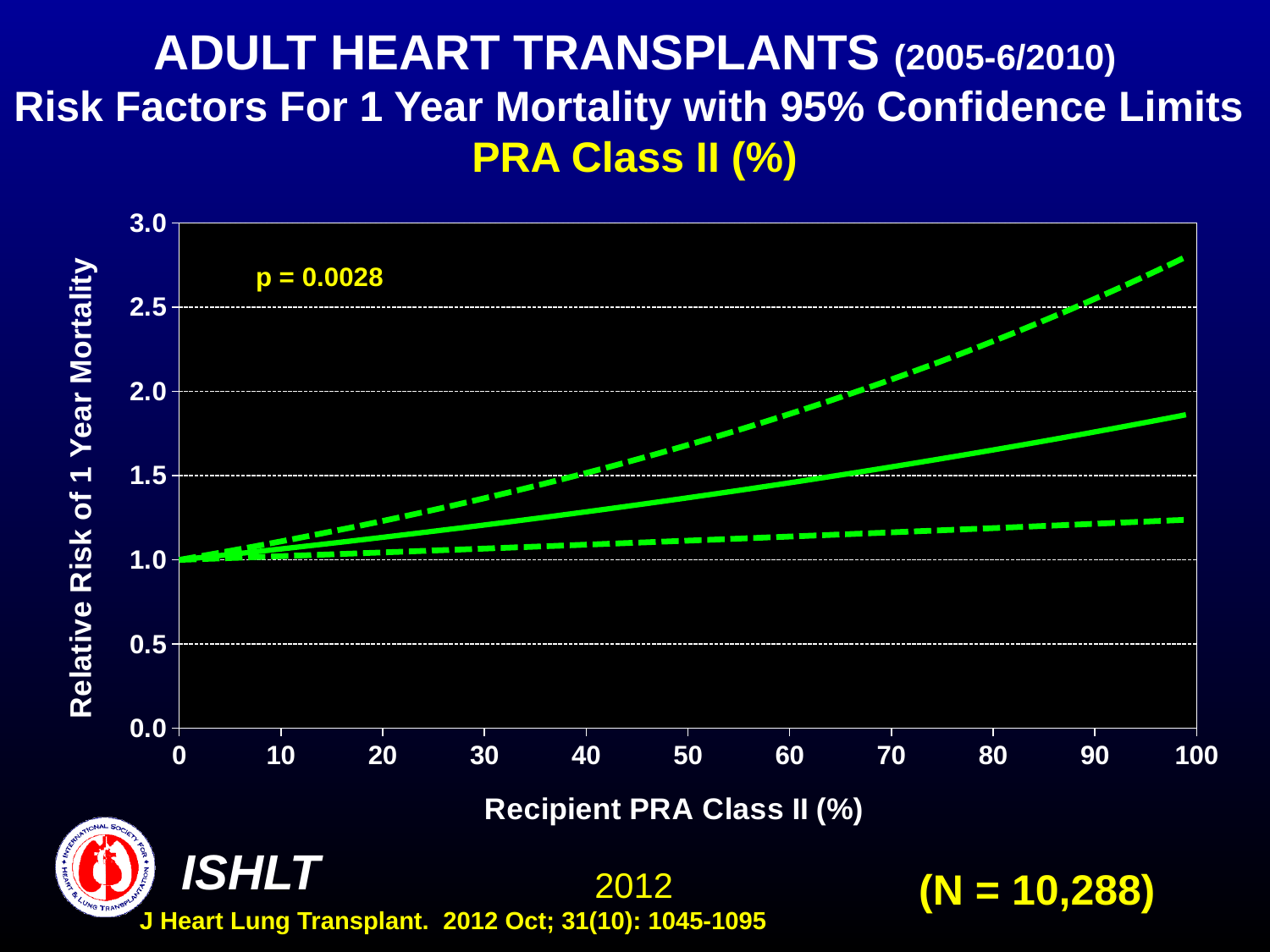
What p-value is shown on the chart? p = 0.0028 What sample size (N) is shown on the slide? N = 10,288 Does the relative risk of 1 year mortality (solid line) rise or fall as Recipient PRA Class II (%) increases? rise How many lines are plotted on the chart? 3 What kind of chart is shown on the slide? line chart Is the relative risk on the solid line at a Recipient PRA Class II of 100% greater or less than 1.5? greater Is the lower 95% confidence limit (lower dashed line) at a Recipient PRA Class II of 100% greater or less than 1.5? less Is the relative risk on the solid line at a Recipient PRA Class II of 100% greater or less than 2.0? less What is the relative risk of 1 year mortality at a Recipient PRA Class II of 0%? 1.0 At a Recipient PRA Class II of 100%, which is larger: the upper dashed line or the solid line? the upper dashed line